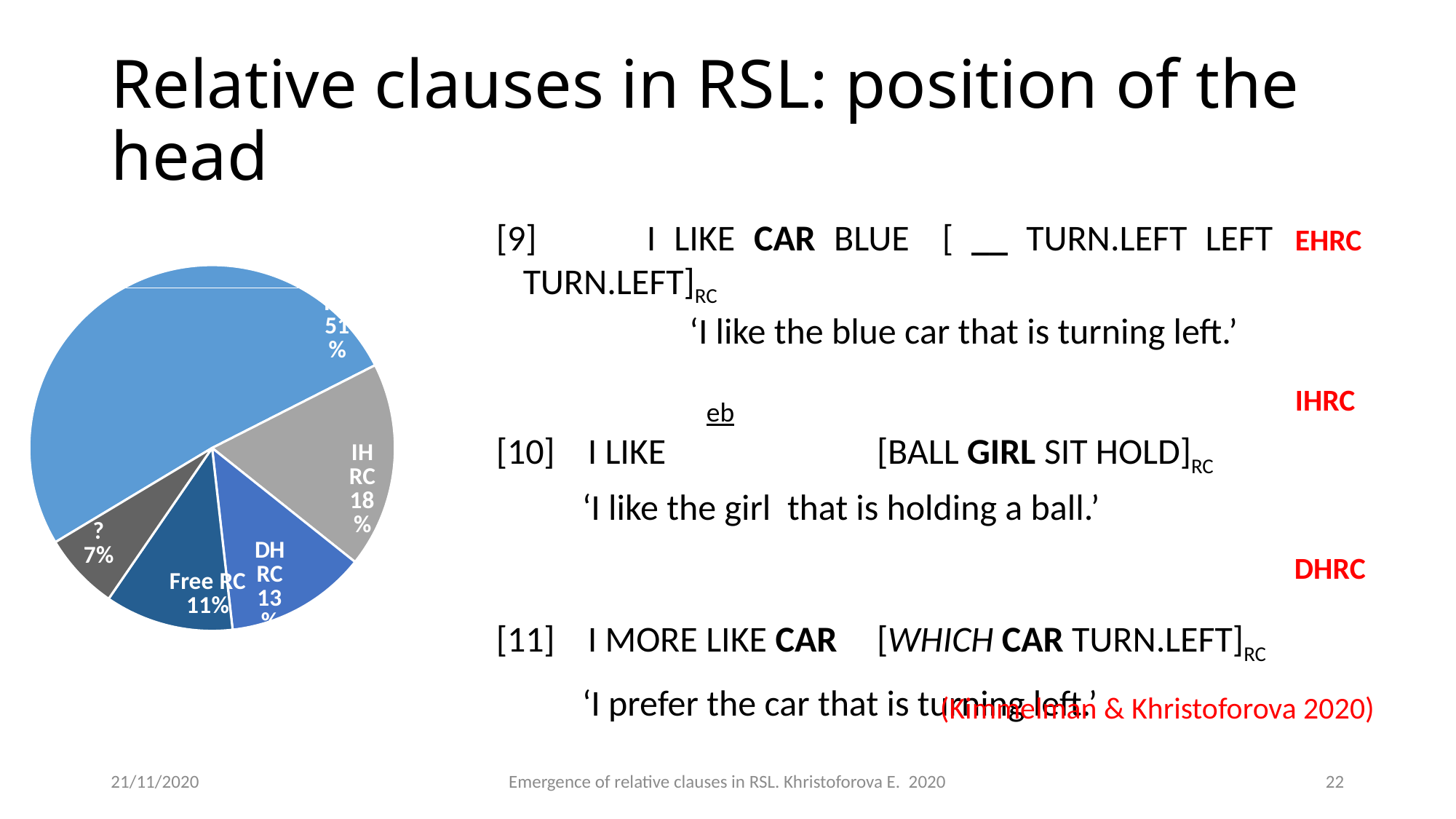
What percentage of the pie chart is labelled DH RC? 13% What colour is the IH RC slice of the pie chart? grey How many slices does the pie chart have? 5 What percentage of the pie chart is labelled Free RC? 11% Which labelled slice of the pie chart is the smallest? ? What type of chart is shown on the slide? pie chart Which slice is larger, IH RC or Free RC? IH RC What percentage of the pie chart is labelled IH RC? 18% What is the difference in percentage points between the Free RC slice and the ? slice? 4% What percentage of the pie chart is labelled with a question mark (?)? 7% What is the largest percentage shown on the pie chart? 51% What is the difference in percentage points between the IH RC slice and the DH RC slice? 5%